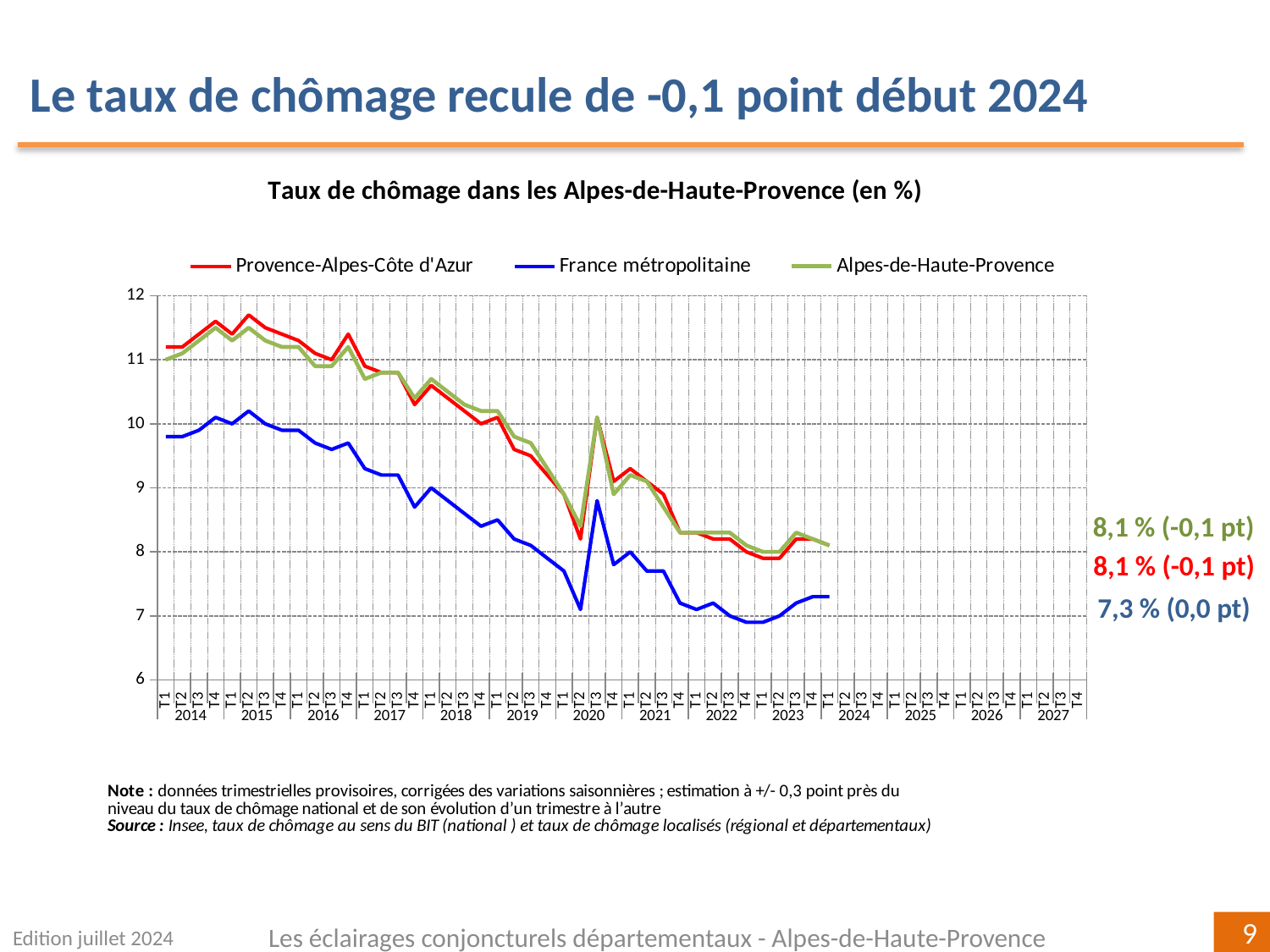
Overall, does the France métropolitaine line rise or fall from 2014 to 2024? fall What is the latest unemployment rate shown for France métropolitaine? 7,3 % Is the value for Provence-Alpes-Côte d'Azur in T2 2015 greater or less than 11? greater What is the latest unemployment rate shown for Alpes-de-Haute-Provence? 8,1 % How many series does the legend list? 3 By how much did the Alpes-de-Haute-Provence rate change in the latest quarter, according to the label? -0,1 pt Which series has the lowest value at the end of the plotted period? France métropolitaine What colour is the France métropolitaine line? blue By how much did the France métropolitaine rate change in the latest quarter, according to the label? 0,0 pt What is the latest unemployment rate shown for Provence-Alpes-Côte d'Azur? 8,1 % What kind of chart is shown on the slide? line chart Is the value for France métropolitaine in T2 2020 greater or less than 8? less